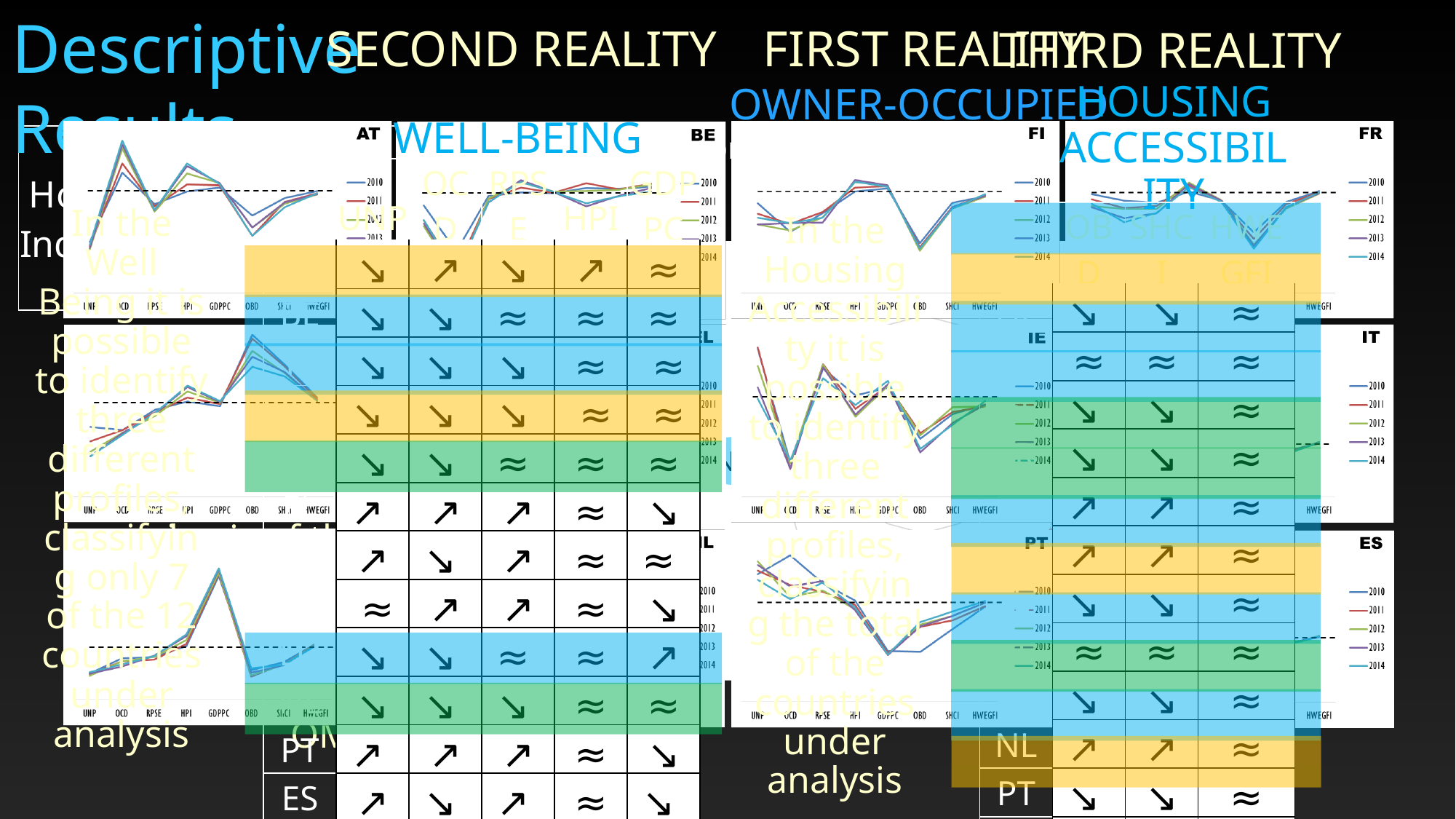
In the AT chart, at which x-axis category do the lines reach their highest point? OCD What kind of chart is the chart labelled AT? line chart Which years are listed in the legend of the FI chart? 2010, 2011, 2012, 2013, 2014 In the IE chart, at which x-axis category do the lines reach their lowest point? OCD What is the first category on the x axis of the IE chart? UNP How many categories are shown on the x axis of the IE chart? 8 In the AT chart, at which x-axis category do the lines reach their lowest point? OBD How many series does the legend of the ES chart list? 5 In the FI chart, at which x-axis category do the lines reach their lowest point? OBD How many series does the legend of the FR chart list? 5 In the IE chart, at which x-axis category do the lines reach their highest point? UNP In the bottom-left line chart, at which x-axis category do the lines reach their highest point? GDPPC